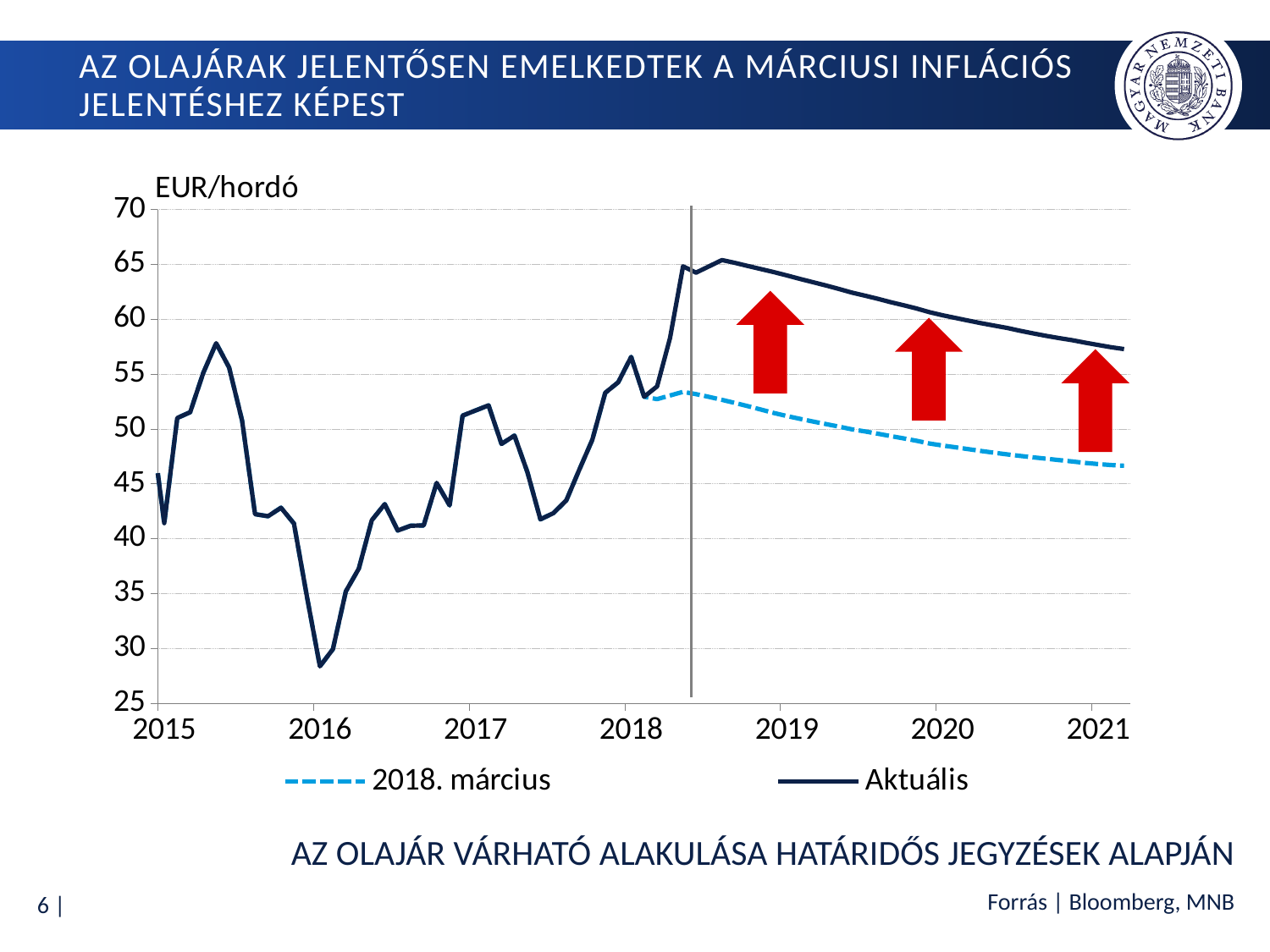
At 2020, which series is higher, Aktuális or 2018. március? Aktuális Between 2019 and 2021, does the 2018. március line rise or fall? fall What is the title printed below the chart? AZ OLAJÁR VÁRHATÓ ALAKULÁSA HATÁRIDŐS JEGYZÉSEK ALAPJÁN How many series does the legend list? 2 Is the Aktuális value at 2021 greater or less than 55? greater Between 2019 and 2021, does the Aktuális line rise or fall? fall Is the 2018. március value at 2019 greater or less than 55? less What are the two series named in the legend? 2018. március and Aktuális Is the lowest point of the Aktuális line, in early 2016, greater or less than 30? less What kind of chart is shown on the slide? line chart